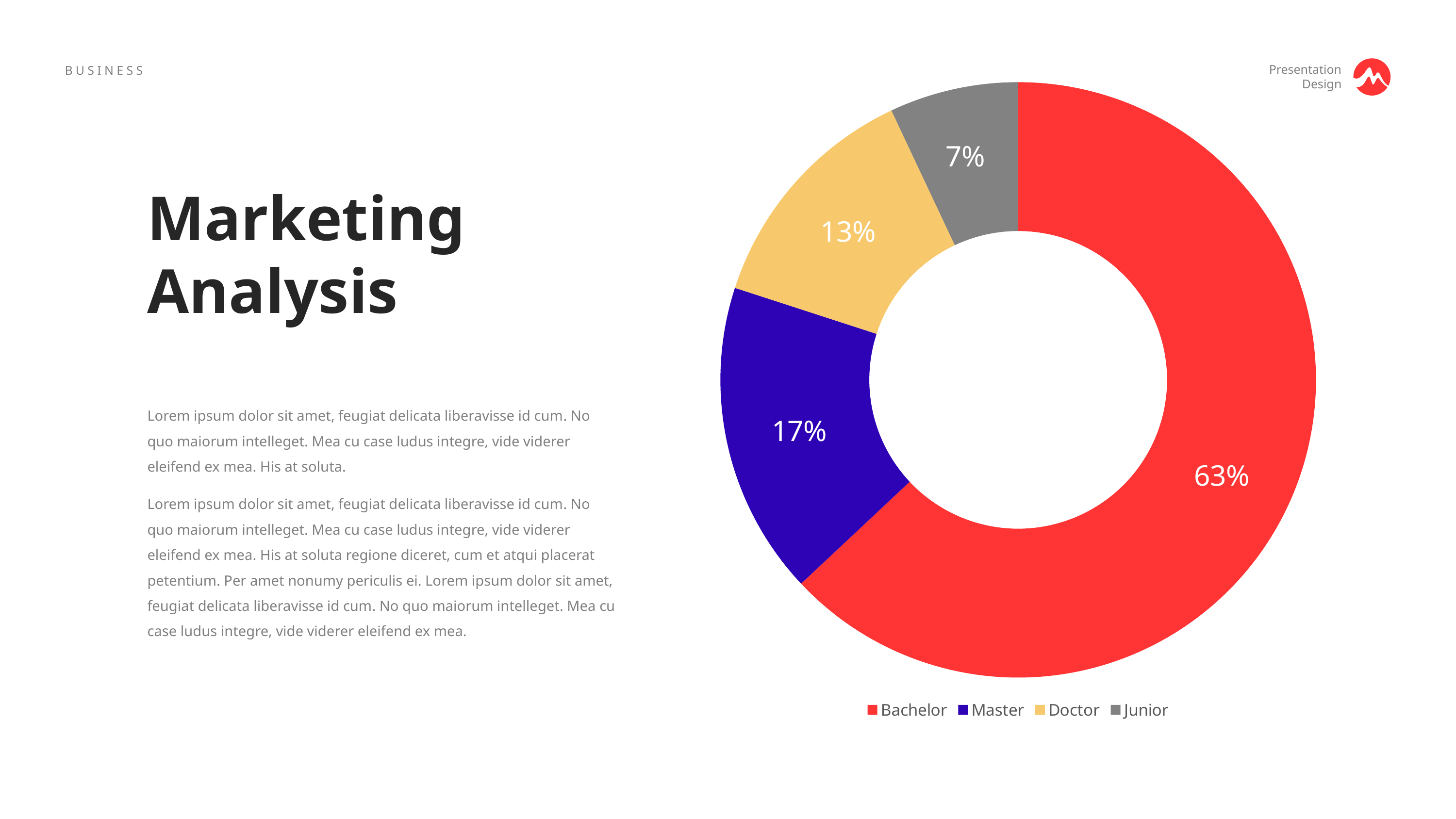
What is the value shown for Junior? 7% What is the value shown for Master? 17% What colour is the Doctor slice? Yellow What is the value shown for Doctor? 13% Which category has the smallest slice? Junior How many categories are shown in the chart? 4 What share of the doughnut chart does Bachelor represent? 63% Which is larger, the Master slice or the Doctor slice? Master Which category has the largest slice? Bachelor What is the difference between the Doctor and Junior shares? 6% What is the difference between the Bachelor and Master shares? 46% What kind of chart is shown on the slide? Doughnut chart